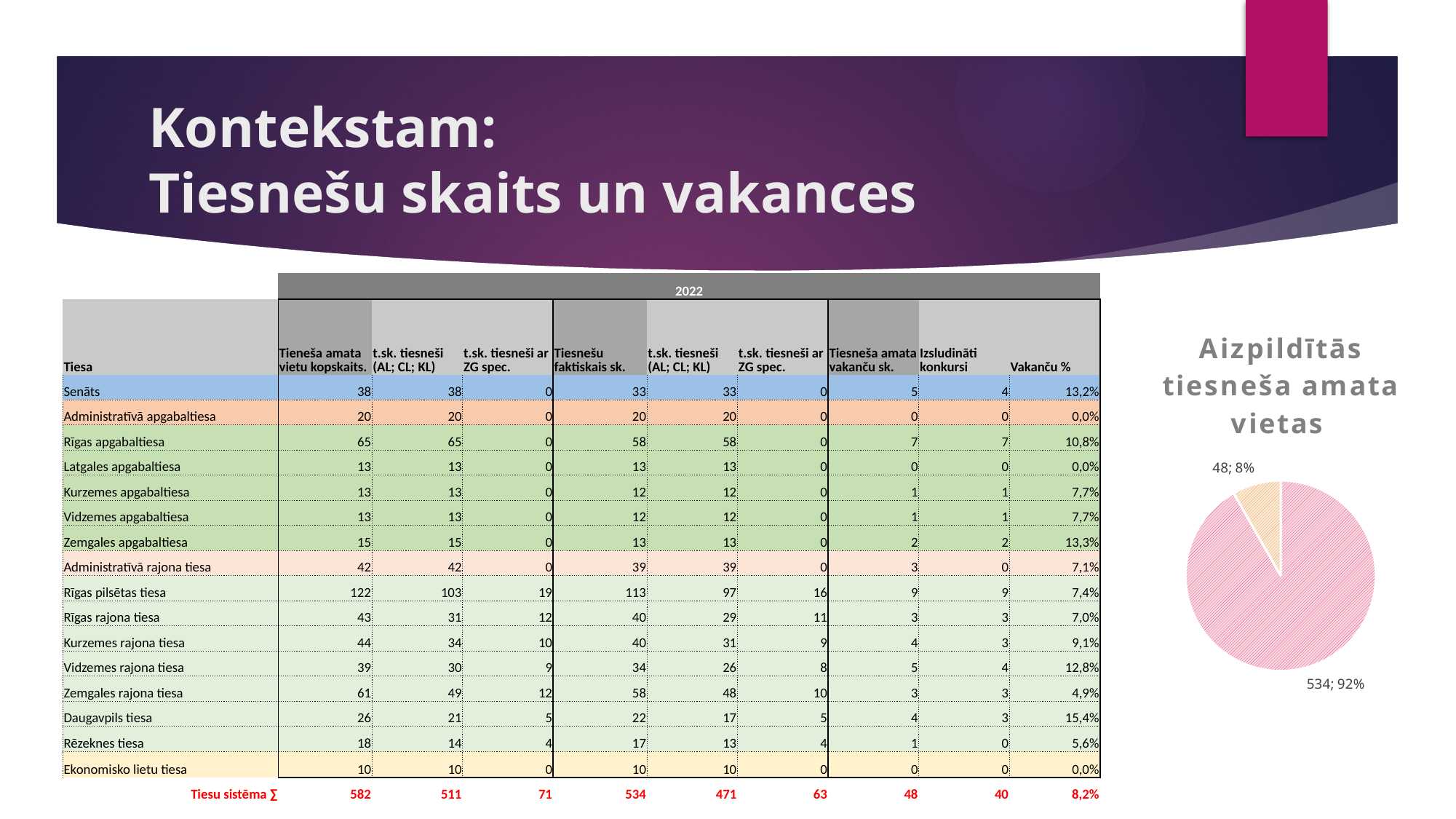
What share of the pie does the slice labelled 534 represent? 92% What share of the pie does the slice labelled 48 represent? 8% What is the sum of the two slice values in the pie chart? 582 What kind of chart is shown on the right of the slide? pie chart How many slices does the pie chart have? 2 What is the title of the pie chart? Aizpildītās tiesneša amata vietas Which slice of the pie chart is larger, the one labelled 534 or the one labelled 48? 534 What is the difference between the two slice values in the pie chart? 486 What colour is the largest slice of the pie chart? pink What value is shown on the largest slice of the pie chart? 534 What value is shown on the smallest slice of the pie chart? 48